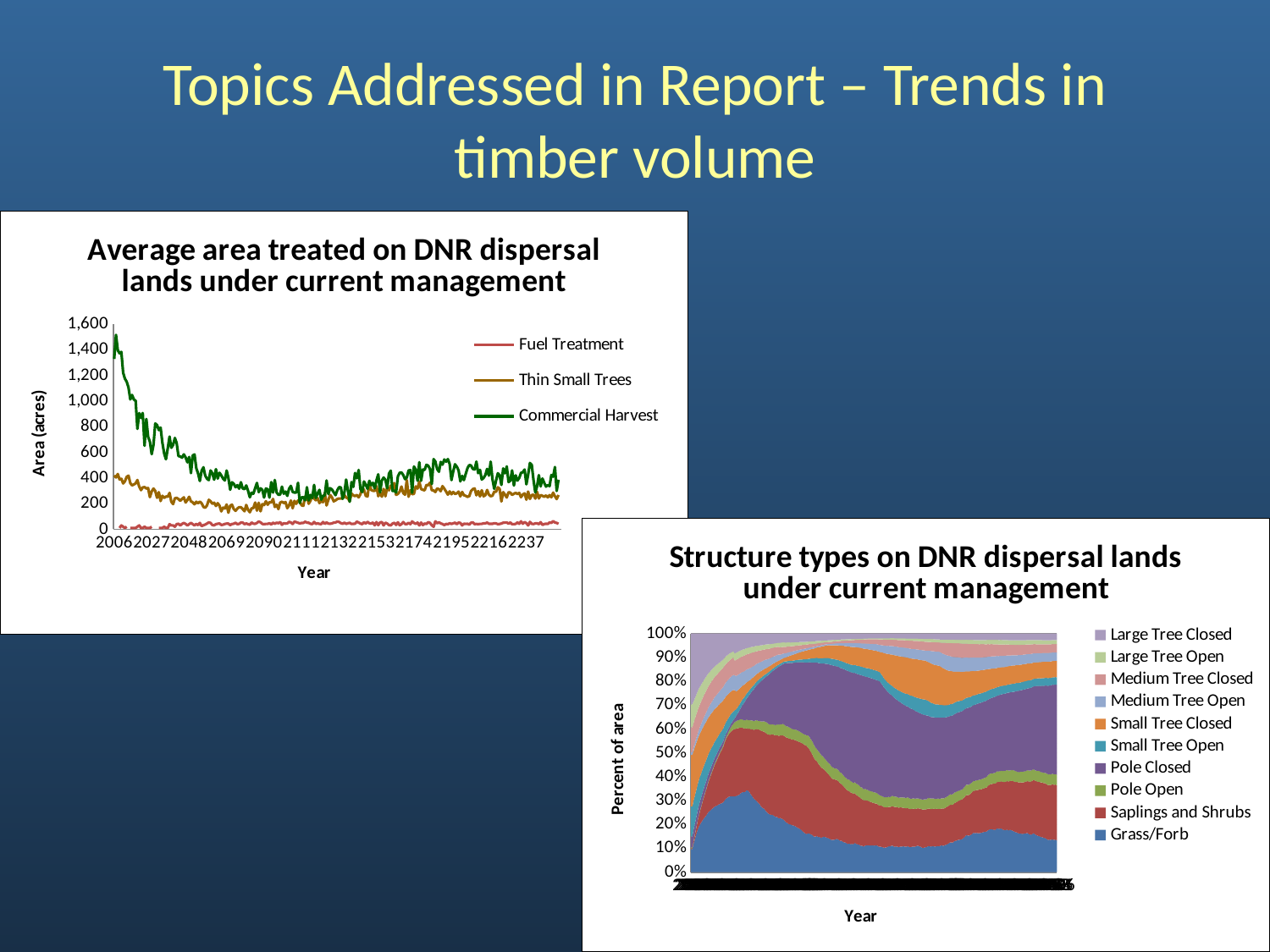
In the 'Average area treated on DNR dispersal lands under current management' chart, which series has the lowest values throughout the period? Fuel Treatment In the 'Average area treated on DNR dispersal lands under current management' chart, is the Fuel Treatment value at 2006 greater or less than 200 acres? less What is the y-axis label of the 'Average area treated on DNR dispersal lands under current management' chart? Area (acres) In the 'Average area treated on DNR dispersal lands under current management' chart, is the Commercial Harvest value at 2006 greater or less than 1,000 acres? greater In the 'Average area treated on DNR dispersal lands under current management' chart, does the Commercial Harvest series overall rise or fall from 2006 to the end of the period? fall What kind of chart is the 'Structure types on DNR dispersal lands under current management' chart? stacked area chart What is the y-axis label of the 'Structure types on DNR dispersal lands under current management' chart? Percent of area How many series does the legend of the 'Average area treated on DNR dispersal lands under current management' chart list? 3 In the 'Average area treated on DNR dispersal lands under current management' chart, which is larger at 2006: Commercial Harvest or Thin Small Trees? Commercial Harvest In the 'Average area treated on DNR dispersal lands under current management' chart, which series has the highest values at the start of the period (2006)? Commercial Harvest How many series does the legend of the 'Structure types on DNR dispersal lands under current management' chart list? 10 What kind of chart is the 'Average area treated on DNR dispersal lands under current management' chart? line chart